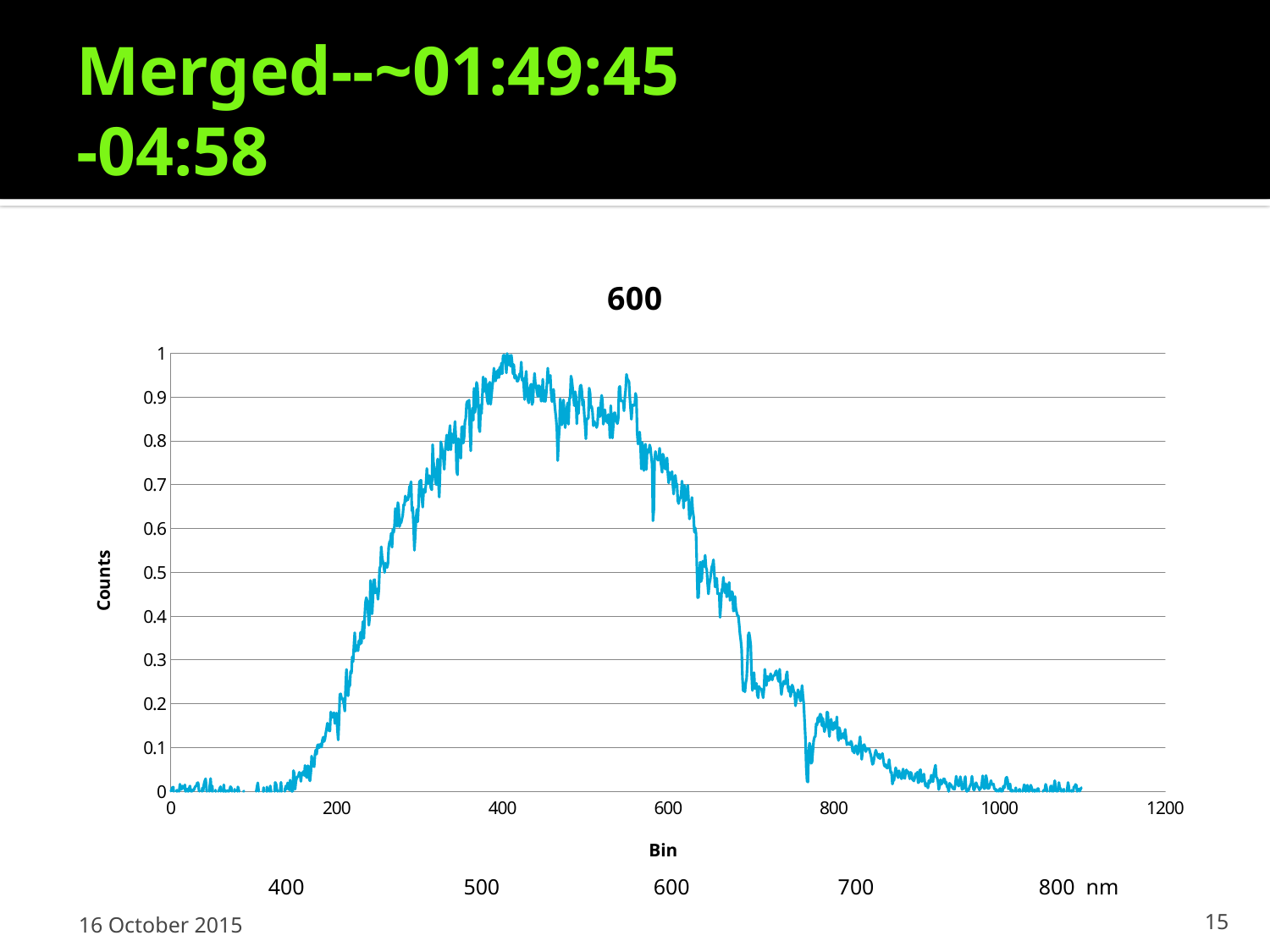
What is the title of the chart? 600 What kind of chart is shown on the slide? line chart Near which labelled x-axis tick does the curve reach its highest value? 400 Is the value of the curve at bin 400 greater or less than 0.8? greater Is the value of the curve higher at bin 400 or at bin 800? bin 400 What is the largest value shown on the x axis of the chart? 1200 Does the curve rise or fall between bin 200 and bin 400? rise Does the curve rise or fall between bin 600 and bin 800? fall What is the label of the y axis of the chart? Counts Is the value of the curve at bin 1000 greater or less than 0.2? less Is the value of the curve at bin 600 greater or less than 0.5? greater